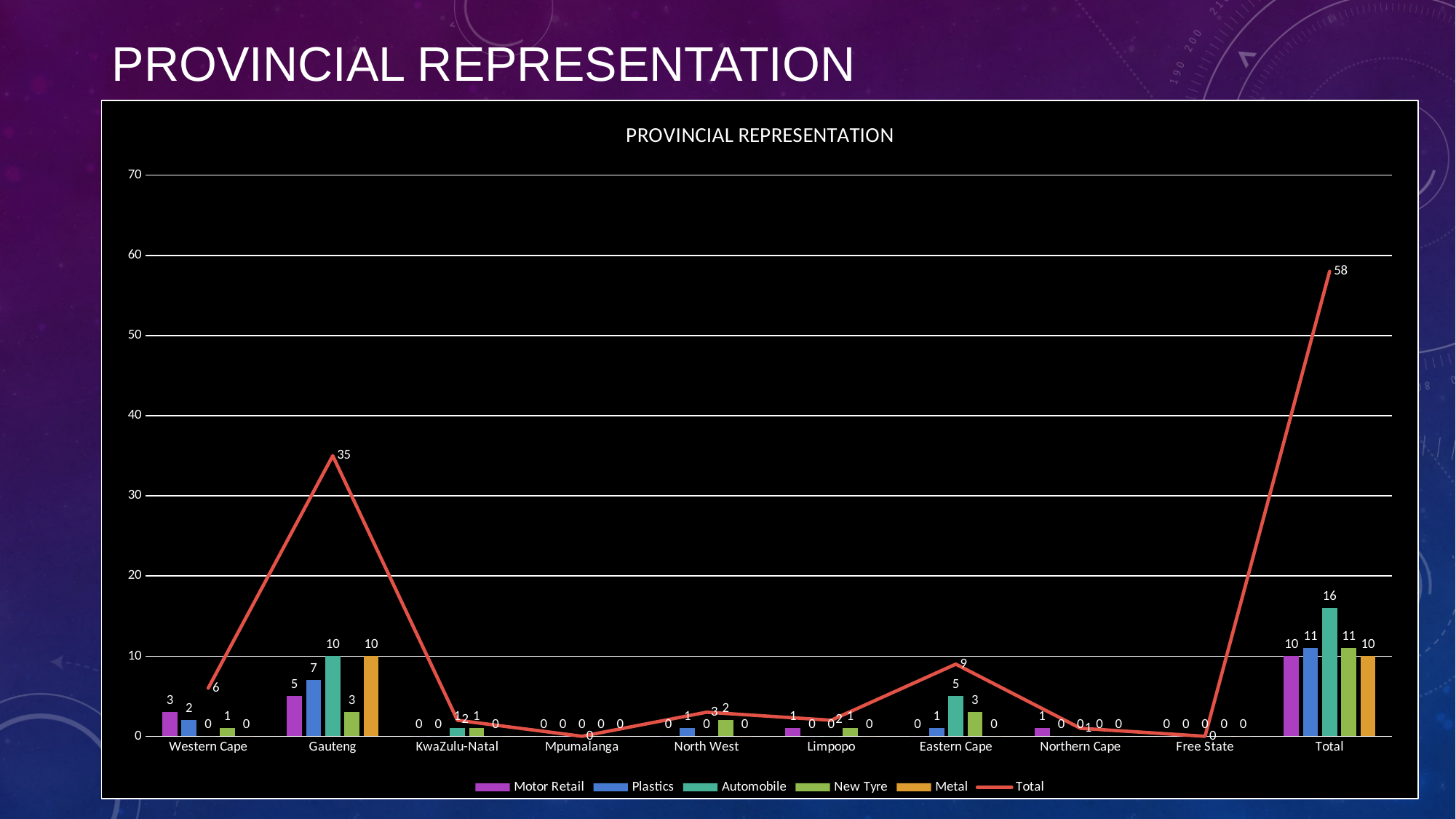
What is the Automobile value for Eastern Cape? 5 What is the difference between the Total value for Gauteng and the Total value for Eastern Cape? 26 How many categories are shown on the x axis? 10 Which series is drawn as a line rather than bars? Total Which is larger, the Metal value for Gauteng or the Metal value for Western Cape? Metal value for Gauteng Which series has the highest value in the Total category? Automobile What is the Total value for Gauteng? 35 Which province (excluding the Total category) has the highest Total value? Gauteng How many series does the legend list? 6 Is the Total value for the Total category greater or less than 50? greater What is the Plastics value for the Total category? 11 What kind of chart is this? Combination bar and line chart